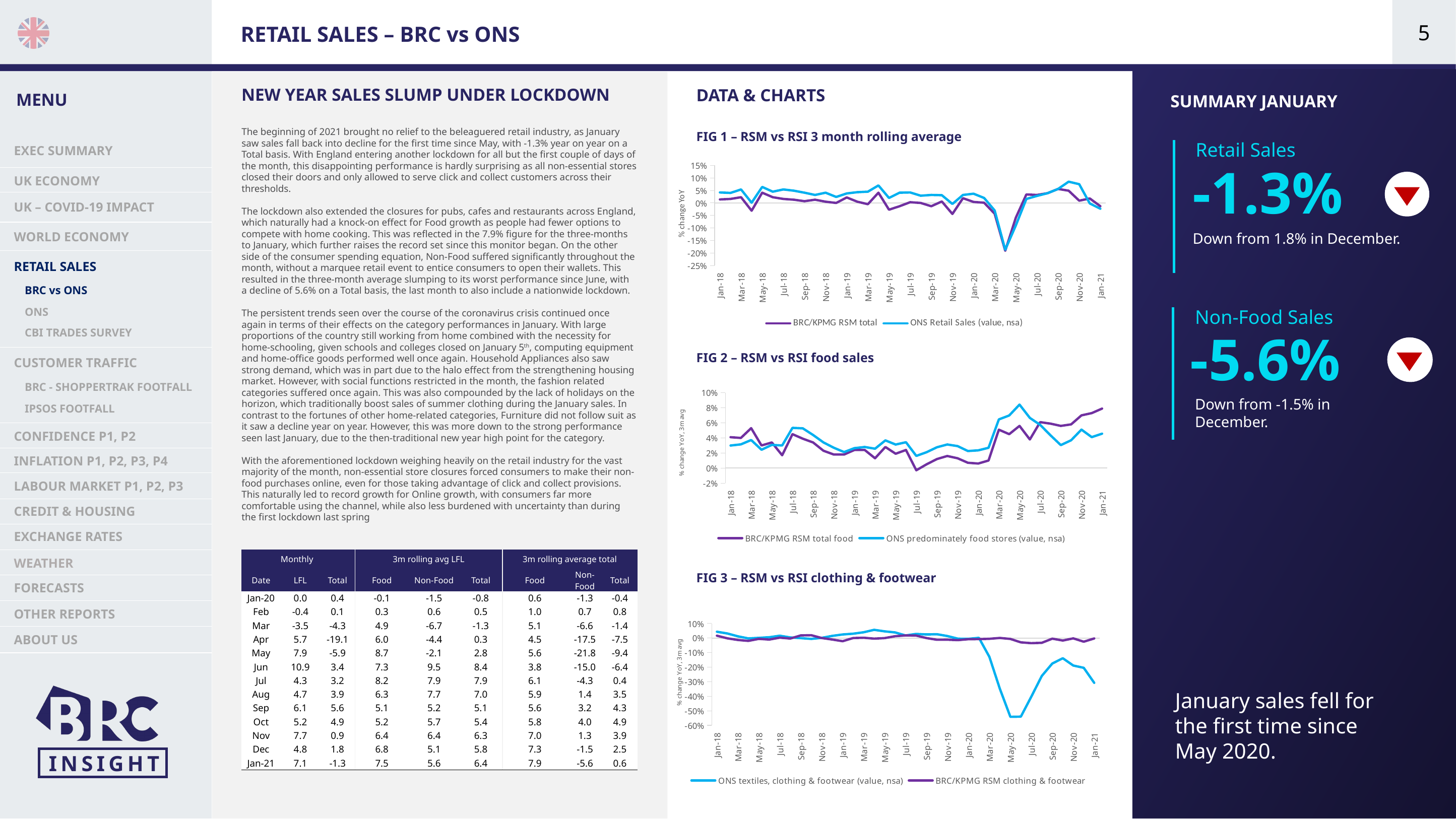
What kind of chart is FIG 1 – RSM vs RSI 3 month rolling average? Line chart In FIG 2 – RSM vs RSI food sales, which series is higher at Jan-21, BRC/KPMG RSM total food or ONS predominately food stores (value, nsa)? BRC/KPMG RSM total food How many charts are shown in the DATA & CHARTS section of the slide? 3 In FIG 3 – RSM vs RSI clothing & footwear, is the value for ONS textiles, clothing & footwear (value, nsa) at May-20 greater or less than -40%? less In FIG 2 – RSM vs RSI food sales, is the value for BRC/KPMG RSM total food at Jan-21 greater or less than 6%? greater How many series does the legend of FIG 1 – RSM vs RSI 3 month rolling average list? 2 In FIG 3 – RSM vs RSI clothing & footwear, which series is higher at Jan-21, ONS textiles, clothing & footwear (value, nsa) or BRC/KPMG RSM clothing & footwear? BRC/KPMG RSM clothing & footwear What are the two legend entries in FIG 2 – RSM vs RSI food sales? BRC/KPMG RSM total food; ONS predominately food stores (value, nsa) In FIG 1 – RSM vs RSI 3 month rolling average, at which month does the BRC/KPMG RSM total series reach its lowest point? Apr-20 In FIG 2 – RSM vs RSI food sales, does the BRC/KPMG RSM total food series rise or fall between Jul-20 and Jan-21? rise